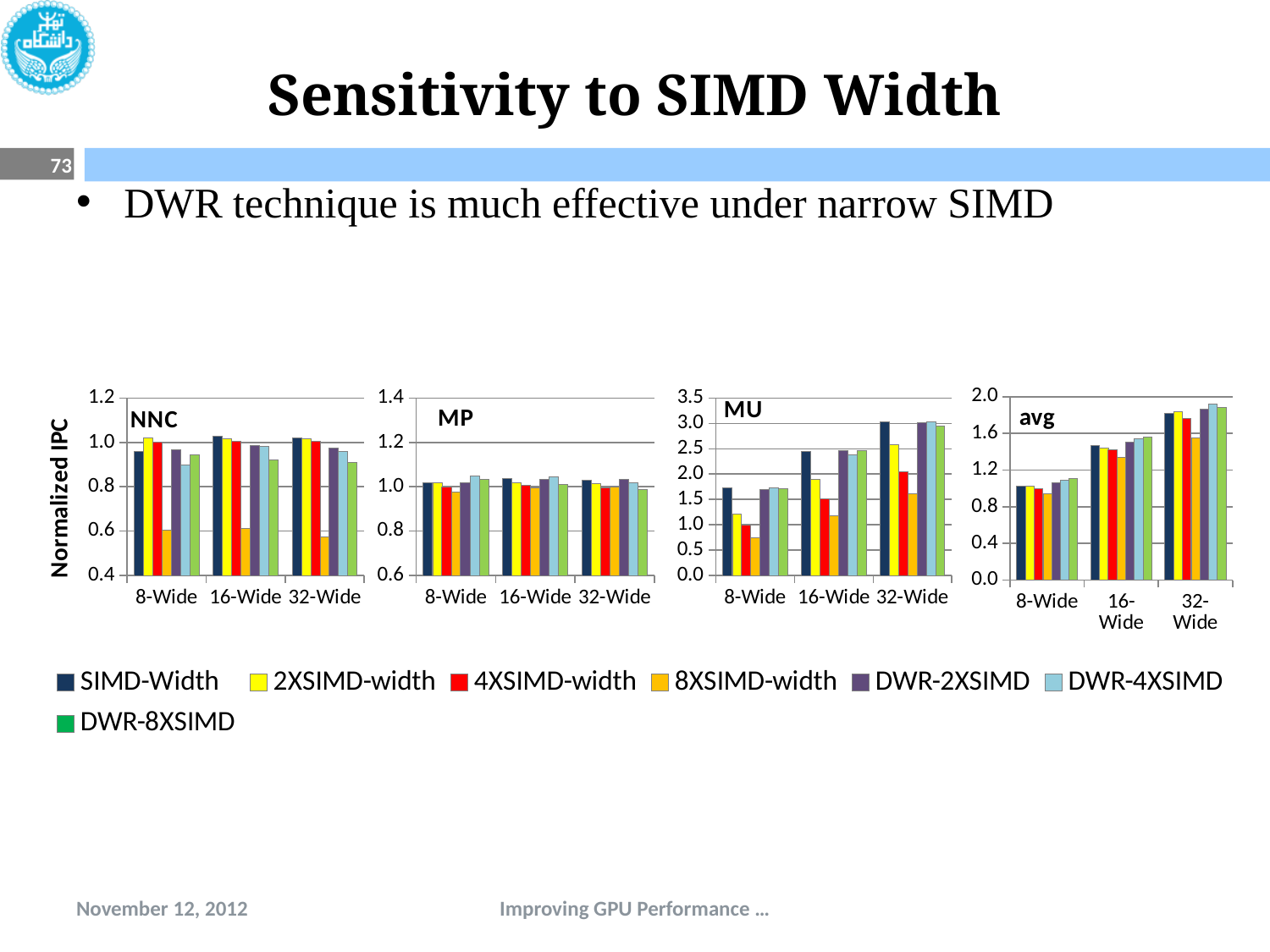
In the MU chart, which series has the lowest value at 8-Wide? 8XSIMD-width How many categories are shown on the x axis of the MU chart? 3 How many series does the legend list for the charts on this slide? 7 In the NNC chart, is the value for 8XSIMD-width at 8-Wide greater or less than 0.8? less What is the y-axis label shown on the leftmost chart? Normalized IPC In the MU chart, does the SIMD-Width series rise or fall from 8-Wide to 32-Wide? rise In the avg chart, is the value for SIMD-Width at 32-Wide greater or less than 1.6? greater In the MU chart, is the value for 8XSIMD-width at 8-Wide greater or less than 1.0? less In the MU chart, which series has the lowest value at 32-Wide? 8XSIMD-width What kind of chart is the NNC chart? bar chart In the NNC chart, which is larger at 8-Wide: SIMD-Width or 8XSIMD-width? SIMD-Width